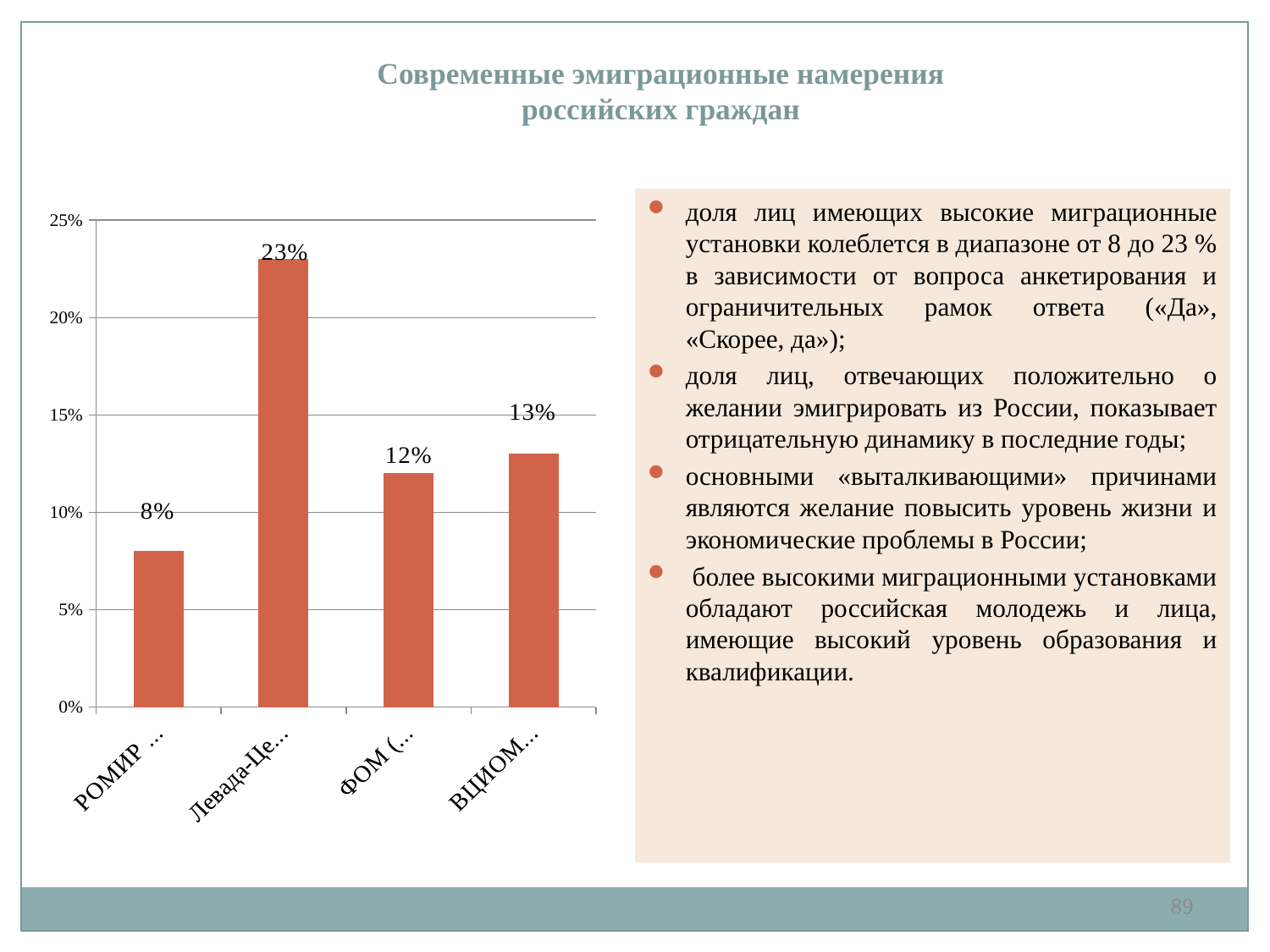
What is the difference between the Левада-Це... value and the РОМИР value? 15% What is the maximum value shown on the vertical axis? 25% Which is larger, the value for ВЦИОМ or the value for ФОМ? ВЦИОМ What kind of chart is shown on the slide? bar chart How many bars are shown in the chart? 4 What is the value for ВЦИОМ? 13% What is the value for the Левада-Це... bar? 23% What is the value for РОМИР? 8% Is the value for РОМИР greater or less than 10%? less What is the value for ФОМ? 12% Which category has the lowest value? РОМИР Which category has the highest value? Левада-Це...